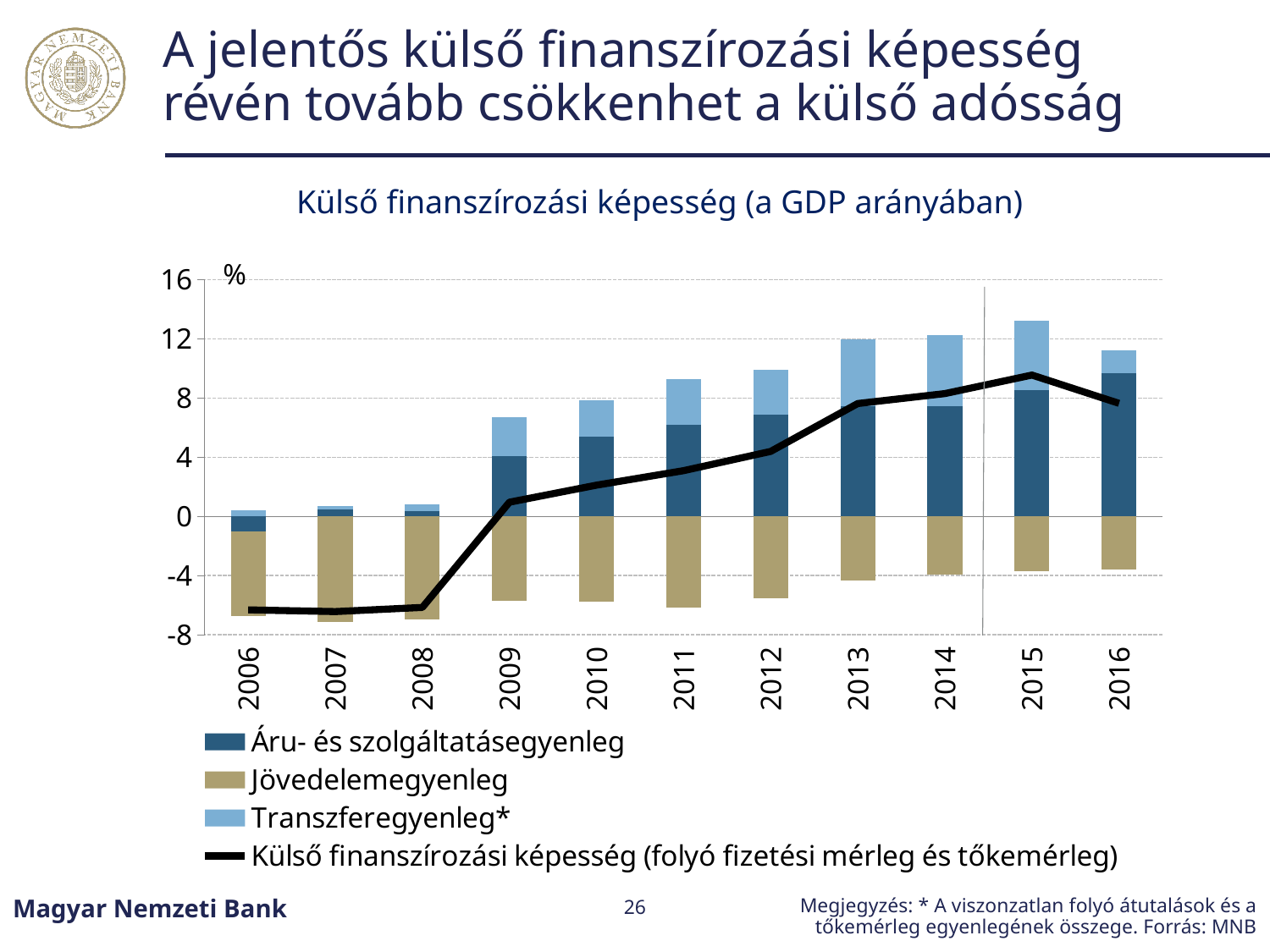
Is the Áru- és szolgáltatásegyenleg value in 2016 greater or less than 8? greater Is the value of the Külső finanszírozási képesség line in 2006 greater or less than -4? less Does the Külső finanszírozási képesség line generally rise or fall from 2006 to 2015? rise What kind of chart is shown on the slide? A stacked bar chart with a line What is the title of the chart? Külső finanszírozási képesség (a GDP arányában) In which year does the Külső finanszírozási képesség line reach its highest value? 2015 Is the Jövedelemegyenleg value in 2007 greater or less than -4? less Which legend entry is drawn as a black line? Külső finanszírozási képesség (folyó fizetési mérleg és tőkemérleg) How many years are shown on the x axis of the chart? 11 How many series does the chart's legend list? 4 Which year has the larger value of the Külső finanszírozási képesség line, 2010 or 2013? 2013